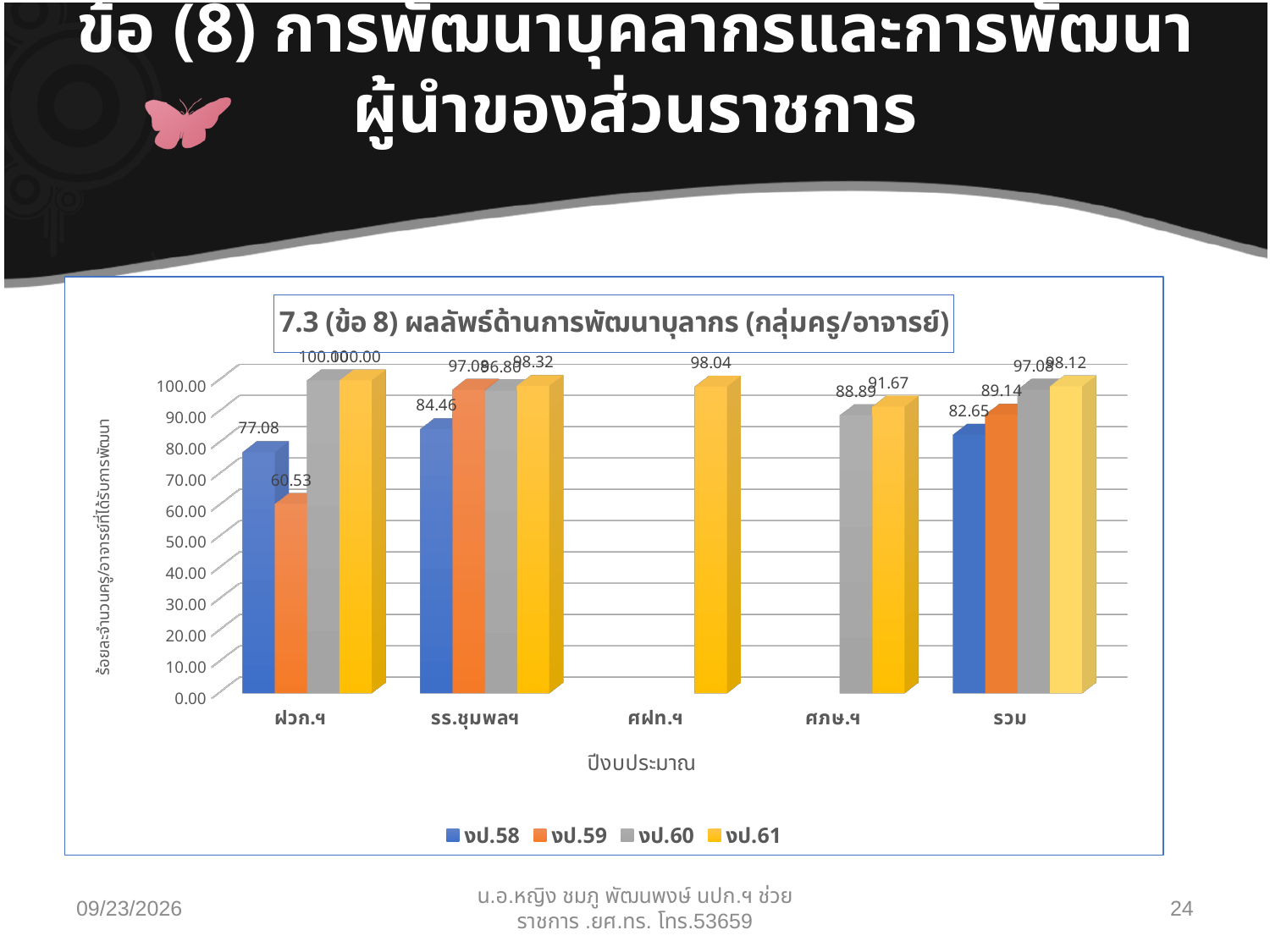
How many series does the legend list? 4 Which series has the lowest value for ฝวก.ฯ? งป.59 How many categories are shown on the x axis? 5 What kind of chart is shown on the slide? Bar chart What is the value for ศฝท.ฯ in the งป.61 series? 98.04 What is the value for รวม in the งป.58 series? 82.65 What is the difference between the งป.61 and งป.58 values for รวม? 15.47 Which is larger: the งป.59 value for รวม or the งป.58 value for ฝวก.ฯ? งป.59 value for รวม What is the value for ฝวก.ฯ in the งป.58 series? 77.08 What is the value for ฝวก.ฯ in the งป.59 series? 60.53